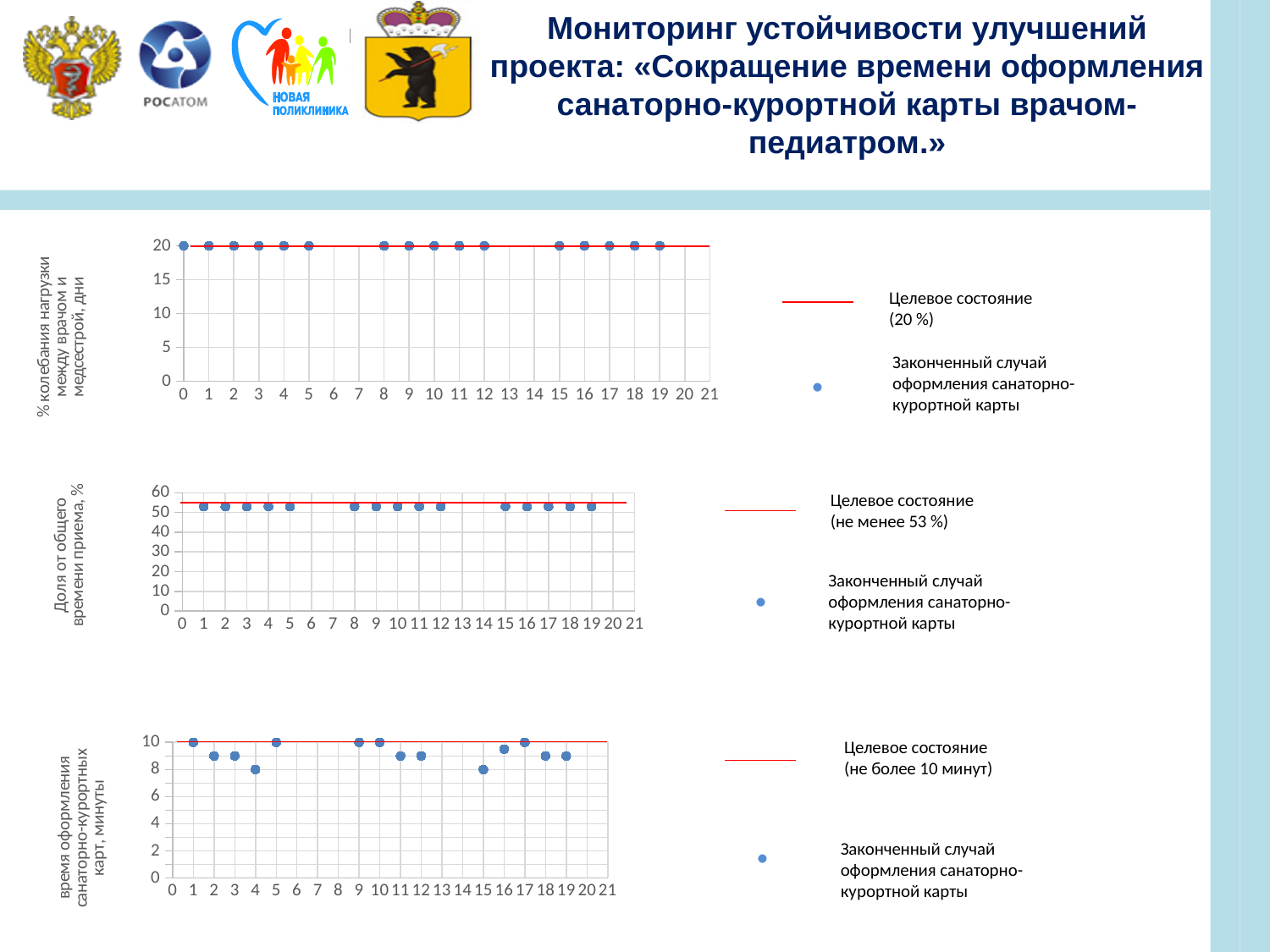
In the bottom chart (время оформления санаторно-курортных карт, минуты), is the value at x = 16 greater or less than 10? less In the top chart (% колебания нагрузки между врачом и медсестрой), what is the value at x = 10? 20 In the middle chart (Доля от общего времени приема, %), is the value at x = 9 greater or less than 40? greater According to the legend of the bottom chart, what is the target state (Целевое состояние)? не более 10 минут In the bottom chart (время оформления санаторно-курортных карт, минуты), is the value at x = 2 greater or less than 8? greater What kind of chart is the top chart on the slide? Scatter chart In the bottom chart (время оформления санаторно-курортных карт, минуты), which is larger: the value at x = 5 or the value at x = 4? x = 5 According to the legend of the top chart, what is the target state (Целевое состояние) value? 20 % In the bottom chart (время оформления санаторно-курортных карт, минуты), what is the value at x = 15? 8 How many data points are plotted in the bottom chart (время оформления санаторно-курортных карт, минуты)? 14 In the bottom chart (время оформления санаторно-курортных карт, минуты), what is the value at x = 1? 10 In the bottom chart (время оформления санаторно-курортных карт, минуты), what is the value at x = 4? 8